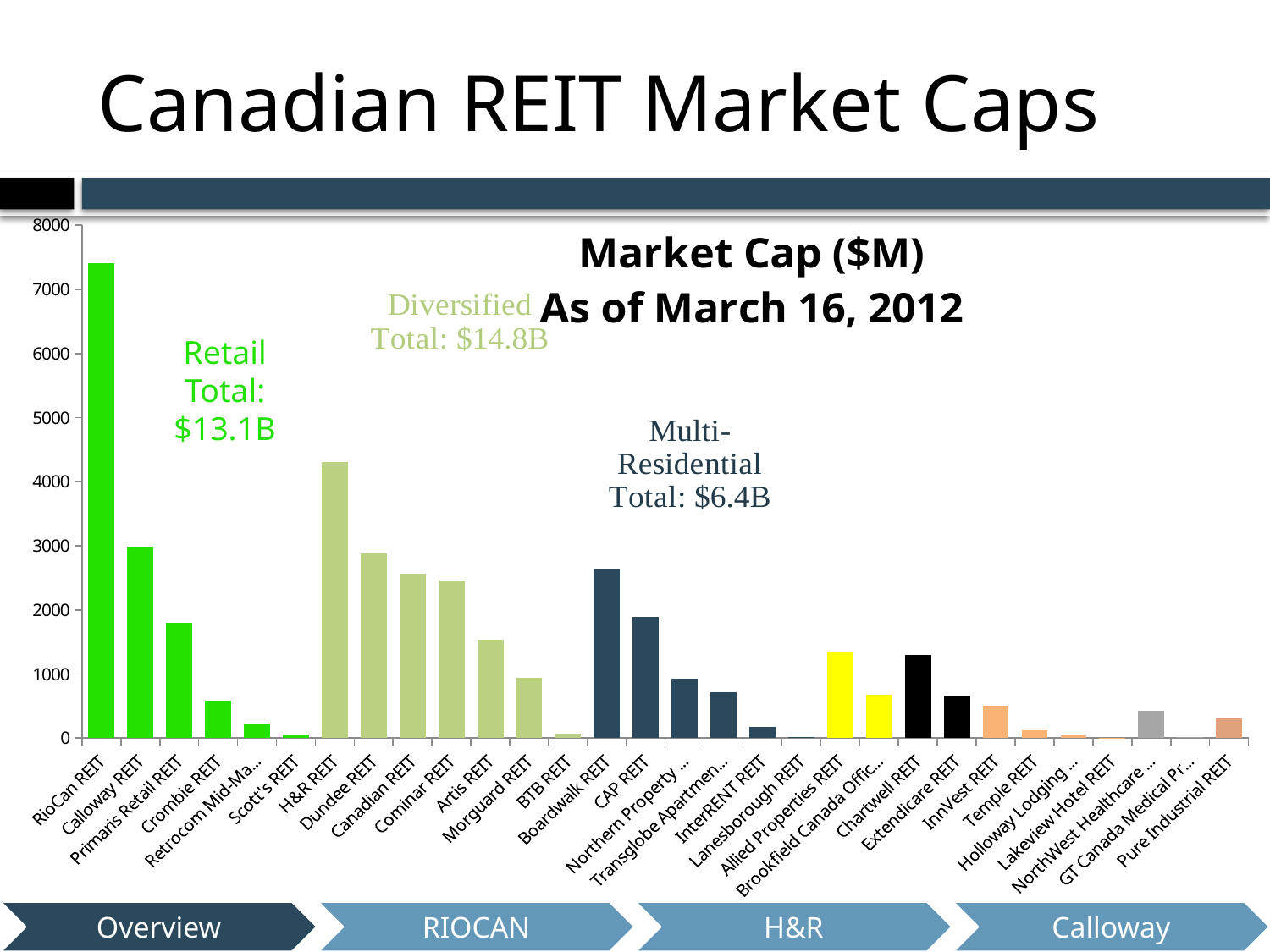
Is the market cap for H&R REIT greater or less than 4000? greater Which has the larger market cap, Artis REIT or Morguard REIT? Artis REIT Is the market cap for Crombie REIT greater or less than 1000? less Which has the larger market cap, H&R REIT or Boardwalk REIT? H&R REIT Is the market cap for Boardwalk REIT greater or less than 2000? greater As of what date are the market caps in the chart reported? March 16, 2012 What is the Retail total shown on the chart? $13.1B Which REIT has the highest market cap in the chart? RioCan REIT How many REITs are plotted along the x axis? 30 What kind of chart is shown on the slide? bar chart